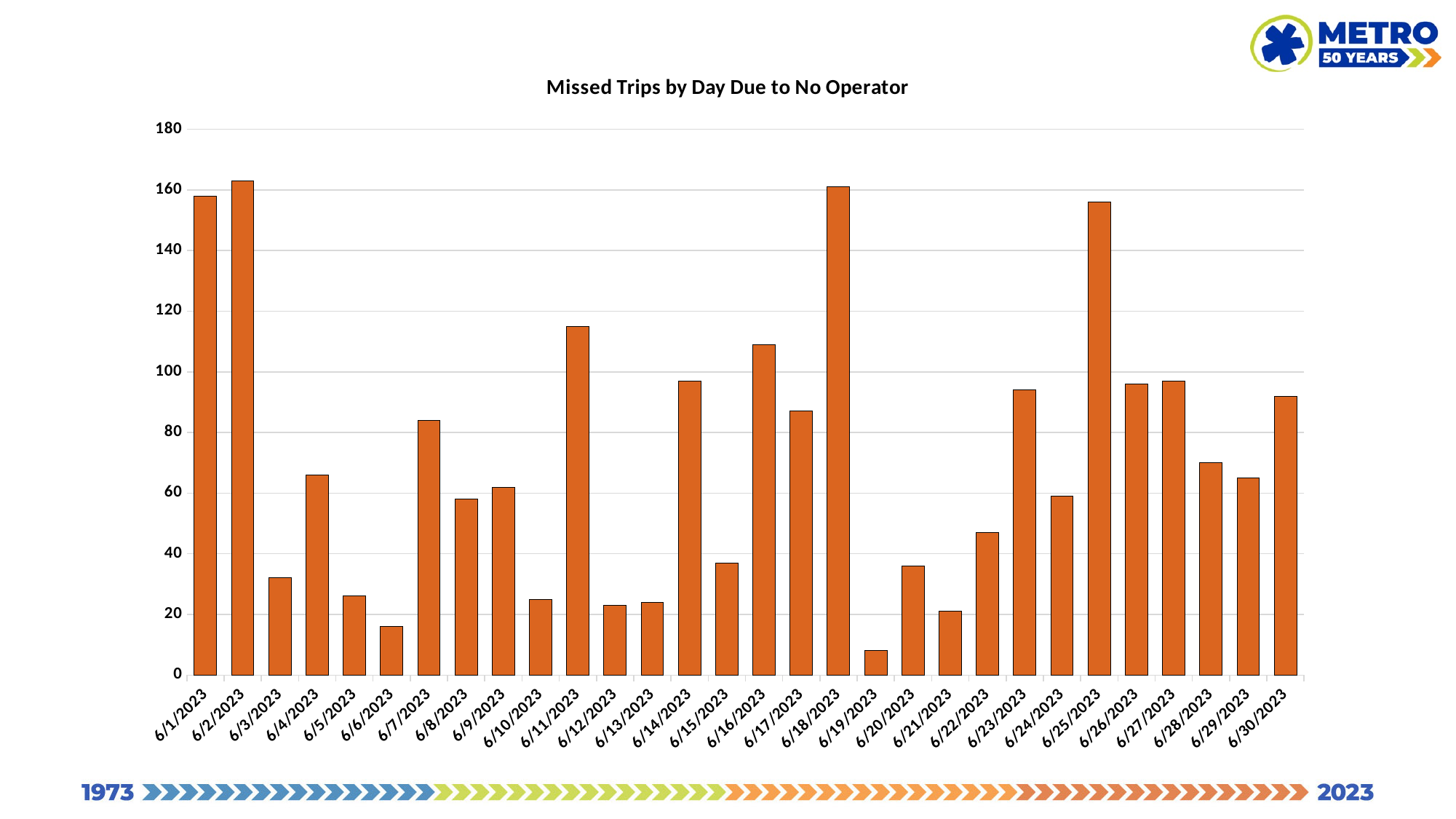
Which day has the lowest number of missed trips? 6/19/2023 Which day has more missed trips, 6/7/2023 or 6/8/2023? 6/7/2023 Is the value for 6/11/2023 greater or less than 100? greater Is the value for 6/19/2023 greater or less than 20? less How many days (bars) are plotted on the chart? 30 Is the value for 6/6/2023 greater or less than 20? less What kind of chart is shown on the slide? bar chart Which day has more missed trips, 6/10/2023 or 6/11/2023? 6/11/2023 Which day has more missed trips, 6/24/2023 or 6/25/2023? 6/25/2023 What is the title of the chart? Missed Trips by Day Due to No Operator